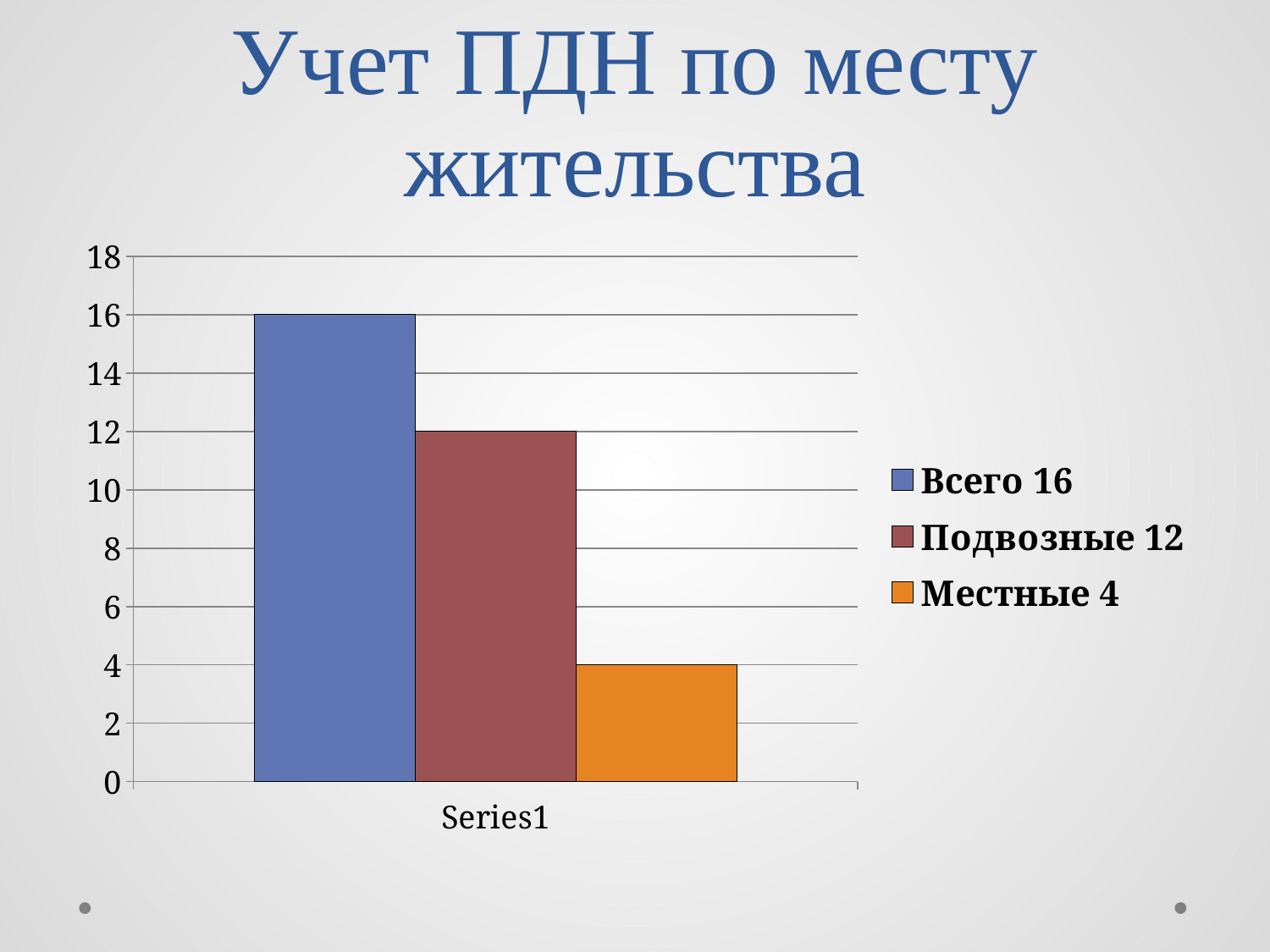
Which series has the highest value? Всего What is the difference between the values for Всего and Подвозные? 4 What is the difference between the values for Подвозные and Местные? 8 What is the value for Подвозные? 12 Is the value for Подвозные greater or less than 10? greater Which series has the lowest value? Местные What is the value for Всего? 16 What is the value for Местные? 4 How many series does the legend list? 3 What is the title of the chart on the slide? Учет ПДН по месту жительства What type of chart is shown on the slide? bar chart Which is larger, the value for Подвозные or the value for Местные? Подвозные